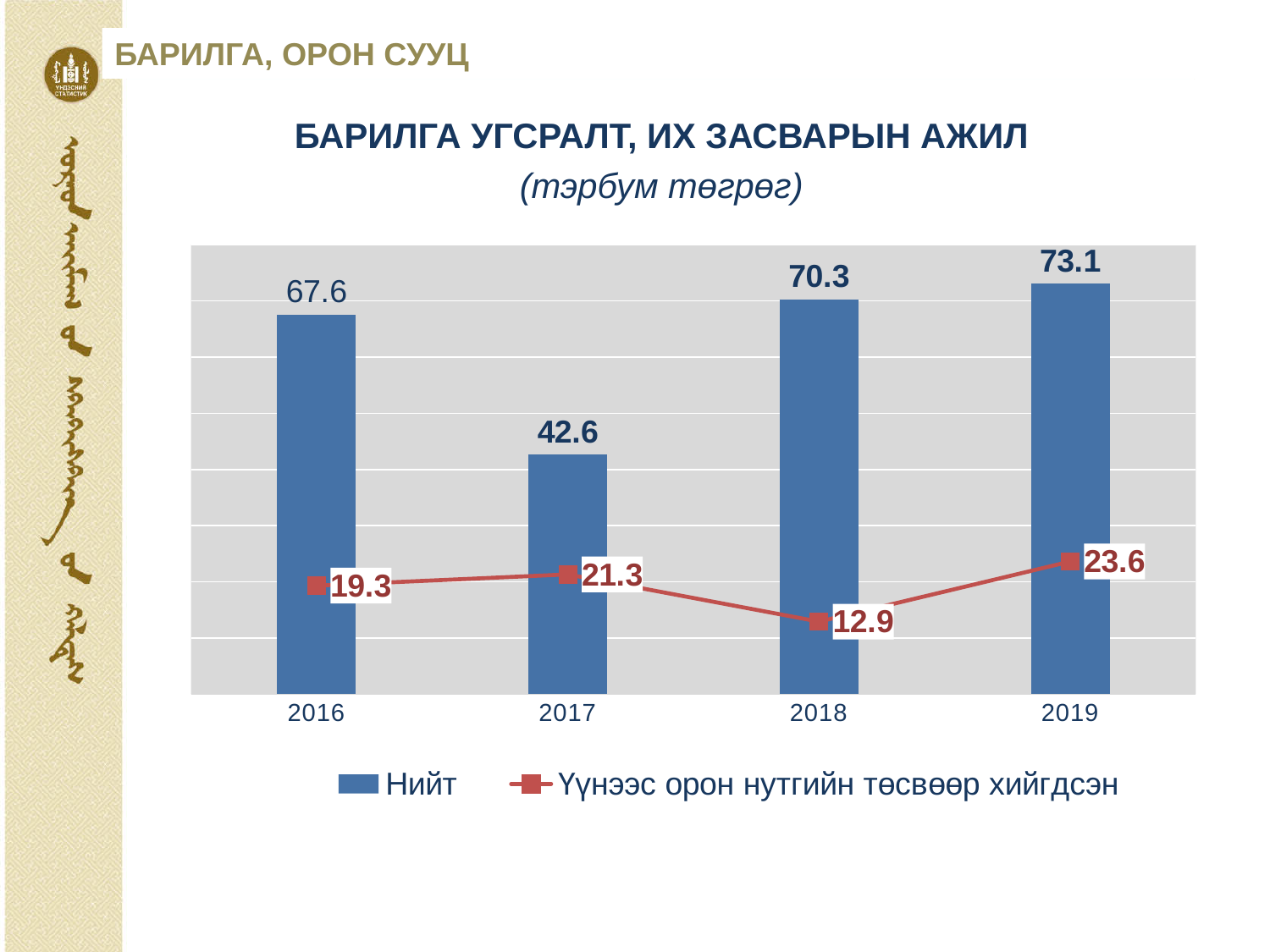
Does the Үүнээс орон нутгийн төсвөөр хийгдсэн value rise or fall from 2018 to 2019? Rise What unit is given in the chart subtitle? тэрбум төгрөг What is the value of Нийт for 2018? 70.3 What is the difference between the Үүнээс орон нутгийн төсвөөр хийгдсэн values for 2019 and 2018? 10.7 What kind of chart is this? Combined bar and line chart What is the value of Үүнээс орон нутгийн төсвөөр хийгдсэн for 2017? 21.3 How many series does the legend list? 2 Which year has the highest Нийт value? 2019 How many years are shown on the x axis? 4 Which is larger, the Нийт value for 2016 or for 2018? 2018 Which year has the lowest Үүнээс орон нутгийн төсвөөр хийгдсэн value? 2018 What is the difference between the Нийт values for 2019 and 2017? 30.5